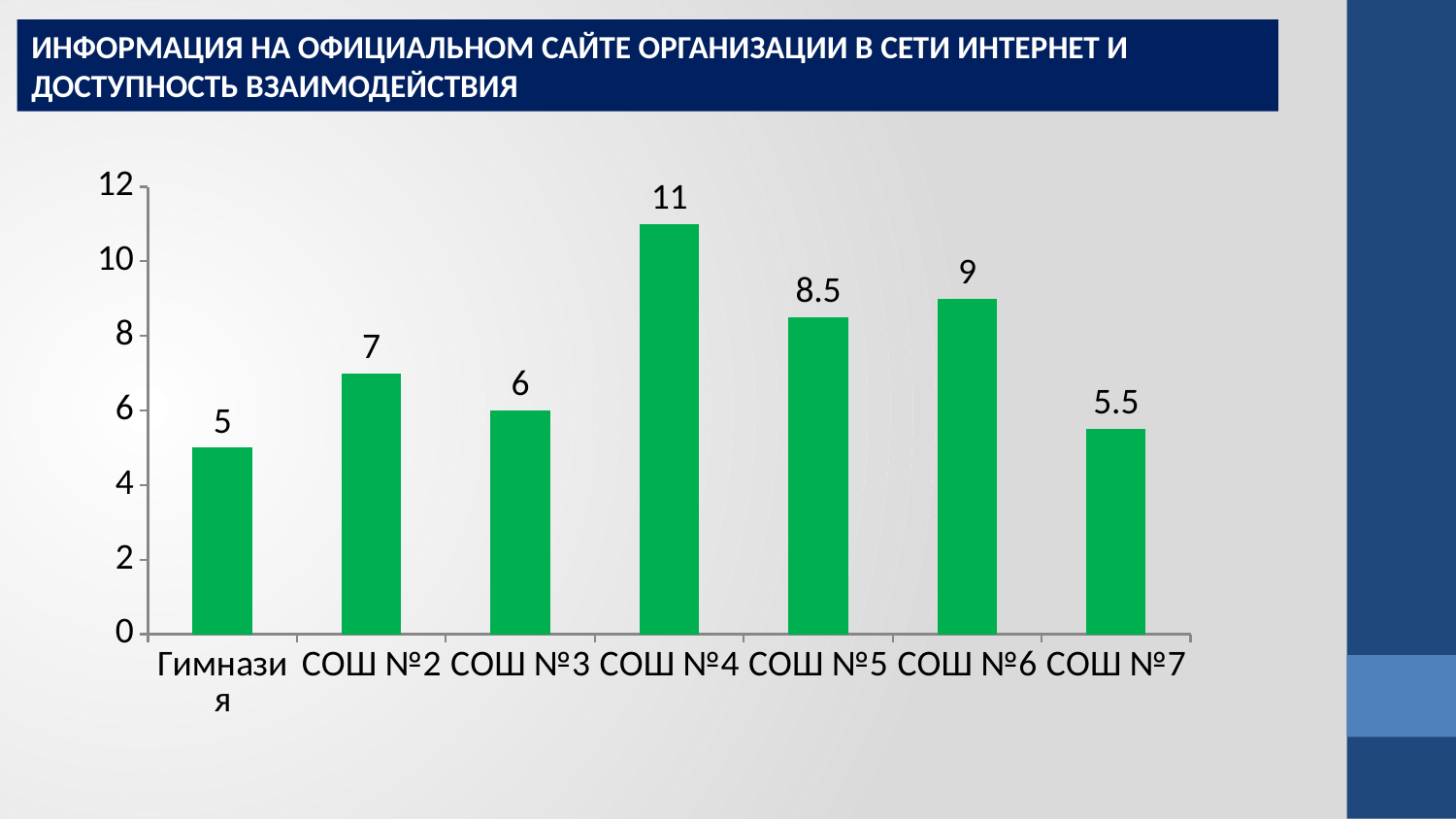
What is the value for Гимназия? 5 What kind of chart is shown on the slide? Bar chart What is the value for СОШ №7? 5.5 What is the difference between the values for СОШ №4 and СОШ №2? 4 What is the value for СОШ №4? 11 What is the value for СОШ №5? 8.5 What is the difference between the values for СОШ №6 and СОШ №7? 3.5 Which category has the highest value? СОШ №4 Which is larger, the value for СОШ №5 or the value for СОШ №3? СОШ №5 What colour are the bars in the chart? Green Which category has the lowest value? Гимназия How many categories are shown on the x axis? 7